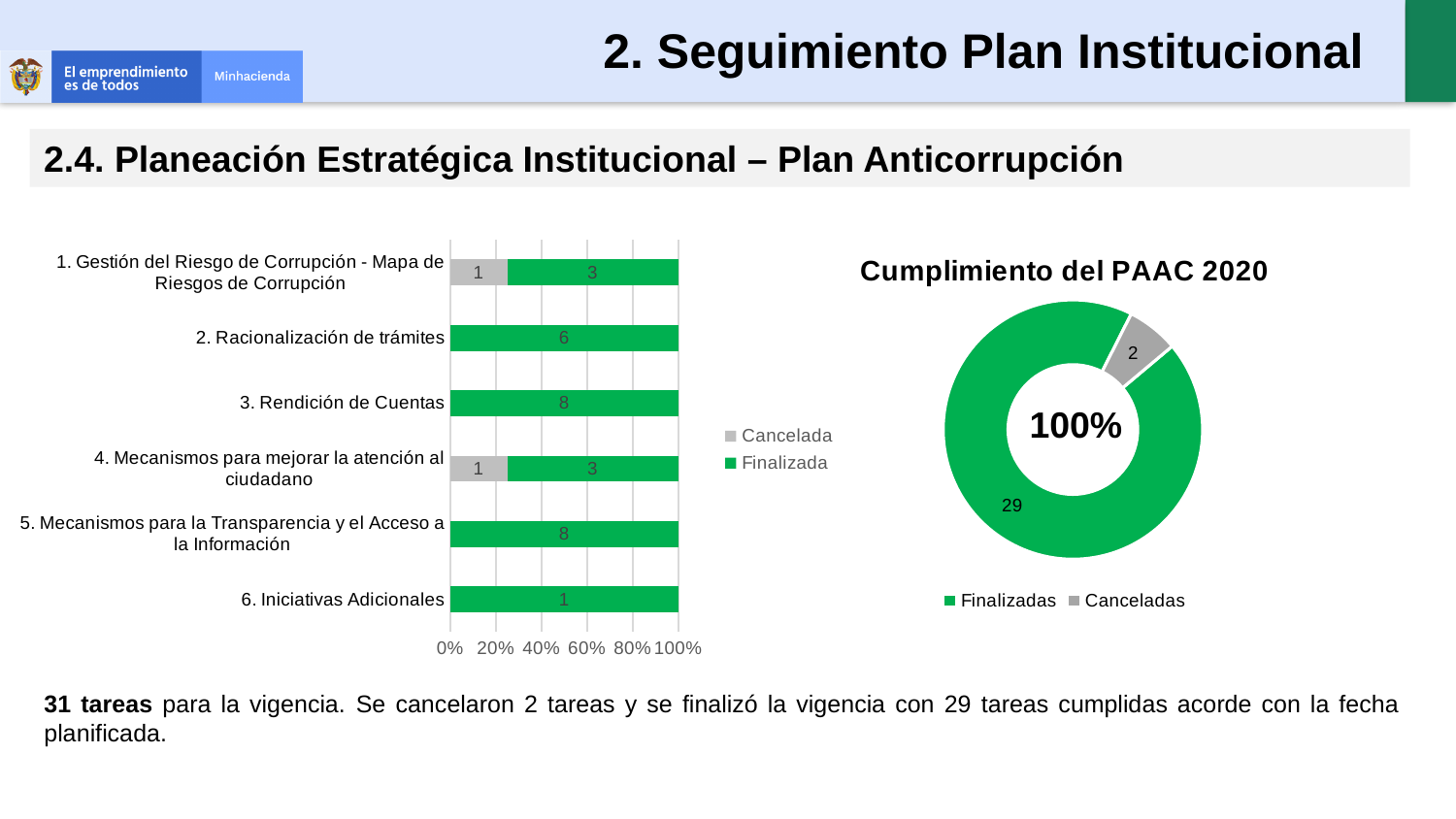
In the bar chart on the left, how many categories are shown on the vertical axis? 6 What kind of chart is the chart on the left of the slide? Bar chart In the bar chart on the left, how many series does the legend list? 2 In the bar chart on the left, what is the Finalizada value for '6. Iniciativas Adicionales'? 1 In the bar chart on the left, what is the Finalizada value for '3. Rendición de Cuentas'? 8 In the chart 'Cumplimiento del PAAC 2020', what is the difference between Finalizadas and Canceladas? 27 In the bar chart on the left, what is the Finalizada value for '2. Racionalización de trámites'? 6 In the bar chart on the left, what is the total of the stacked bar for '4. Mecanismos para mejorar la atención al ciudadano'? 4 In the chart 'Cumplimiento del PAAC 2020', what is the value for Finalizadas? 29 What percentage is printed in the centre of the chart 'Cumplimiento del PAAC 2020'? 100% In the bar chart on the left, what is the Cancelada value for '1. Gestión del Riesgo de Corrupción - Mapa de Riesgos de Corrupción'? 1 In the chart 'Cumplimiento del PAAC 2020', what is the value for Canceladas? 2